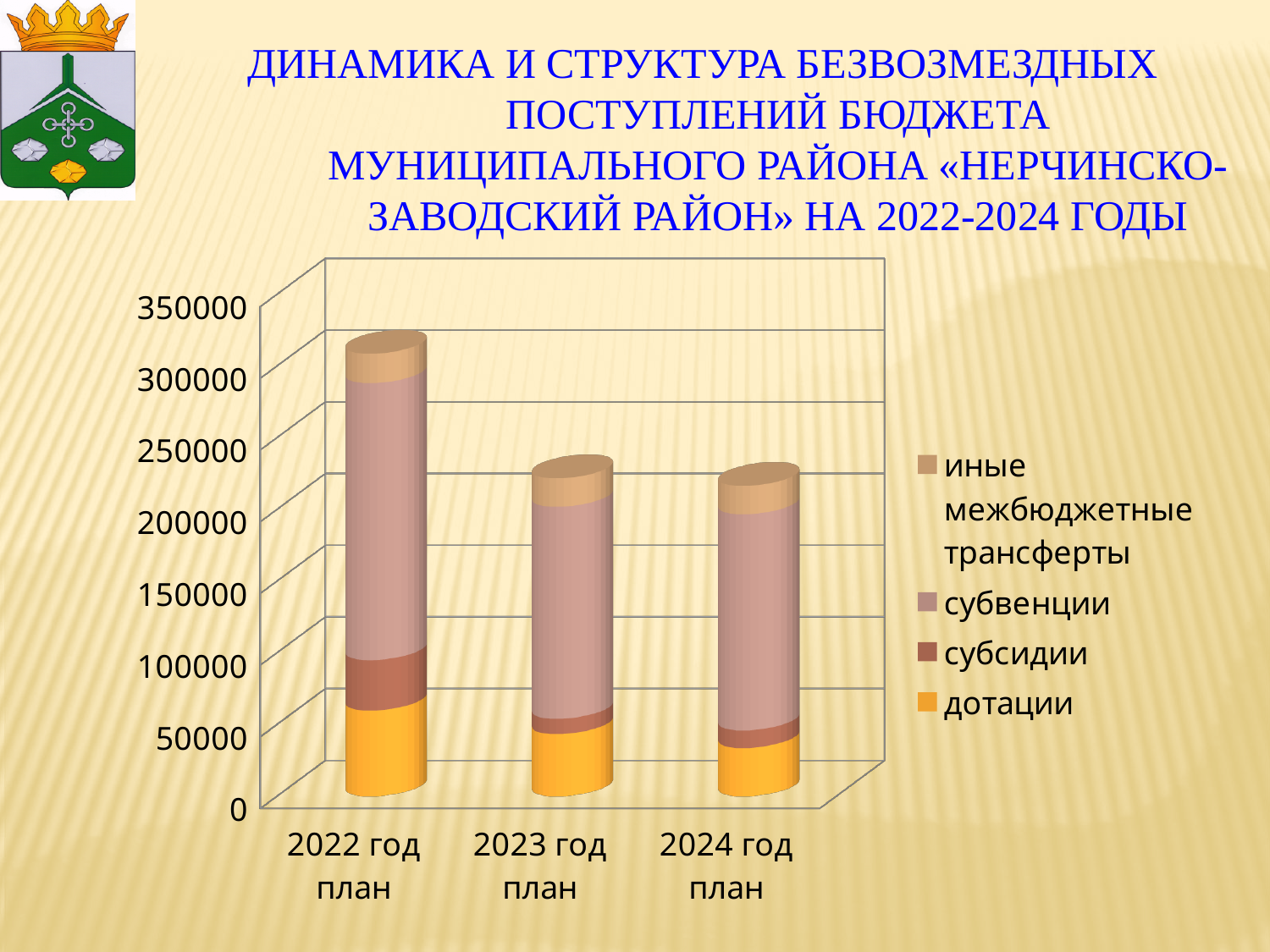
Is the total bar for 2023 год план greater or less than 250000? less Is the total bar for 2022 год план greater or less than 250000? greater How many series does the chart legend list? 4 Is the total bar for 2023 год план greater or less than 200000? greater How many categories (years) are shown on the x axis of the chart? 3 Which series occupies the largest portion of each stacked bar? субвенции Is the total bar for 2022 год план larger or smaller than the total bar for 2024 год план? larger Do the total bar heights generally rise or fall from 2022 to 2024? fall Which year has the highest total bar in the chart? 2022 год план What kind of chart is shown on the slide? bar chart Which series is shown at the bottom of each stacked bar? дотации